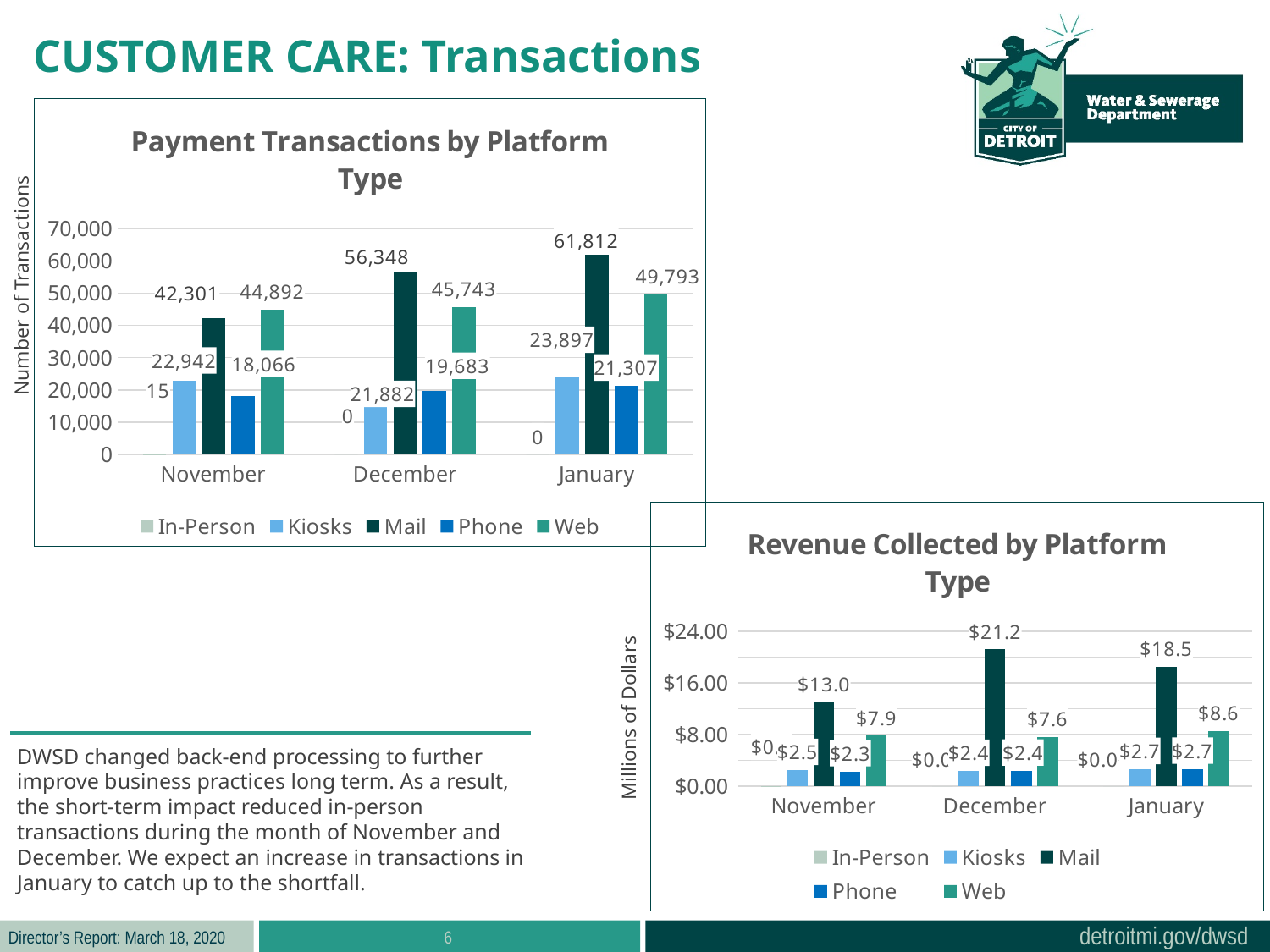
In the Payment Transactions by Platform Type chart, what is the difference between Mail transactions in December and November? 14,047 In the Revenue Collected by Platform Type chart, what is the difference between Mail revenue in December and January? $2.7 In the Revenue Collected by Platform Type chart, which month had the highest Mail revenue? December In the Payment Transactions by Platform Type chart, which had more transactions in November, Mail or Web? Web What type of chart is the Revenue Collected by Platform Type chart? bar chart In the Payment Transactions by Platform Type chart, how many Web transactions were there in November? 44,892 In the Payment Transactions by Platform Type chart, do Web transactions rise or fall from November to January? rise How many months are shown on the x axis of the Payment Transactions by Platform Type chart? 3 In the Payment Transactions by Platform Type chart, how many Mail transactions were there in January? 61,812 In the Revenue Collected by Platform Type chart, how much revenue was collected by Mail in December? $21.2 How many series does the legend of the Payment Transactions by Platform Type chart list? 5 In the Payment Transactions by Platform Type chart, which month had the highest number of Mail transactions? January